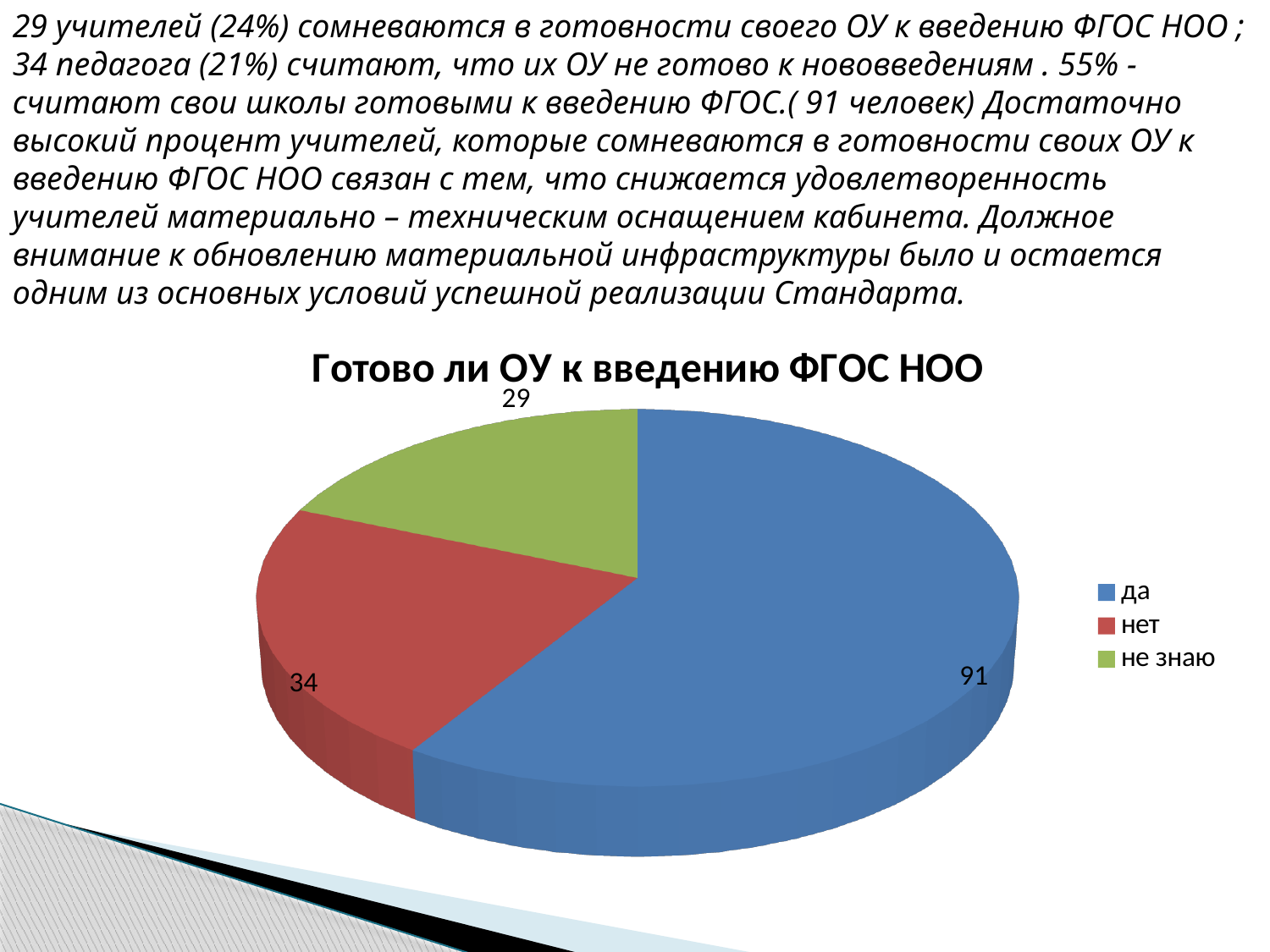
How many slices does the pie chart have? 3 How many entries does the legend of the pie chart list? 3 What kind of chart is shown on the slide? pie chart What is the value of the "нет" slice in the pie chart? 34 What is the title of the chart on the slide? Готово ли ОУ к введению ФГОС НОО Which category has the smallest slice in the pie chart? не знаю What is the difference between the "нет" and "не знаю" values in the pie chart? 5 What is the value of the "не знаю" slice in the pie chart? 29 What is the value of the "да" slice in the pie chart? 91 Which category has the largest slice in the pie chart? да What is the difference between the "да" and "нет" values in the pie chart? 57 Which is larger in the pie chart, the "нет" slice or the "не знаю" slice? нет